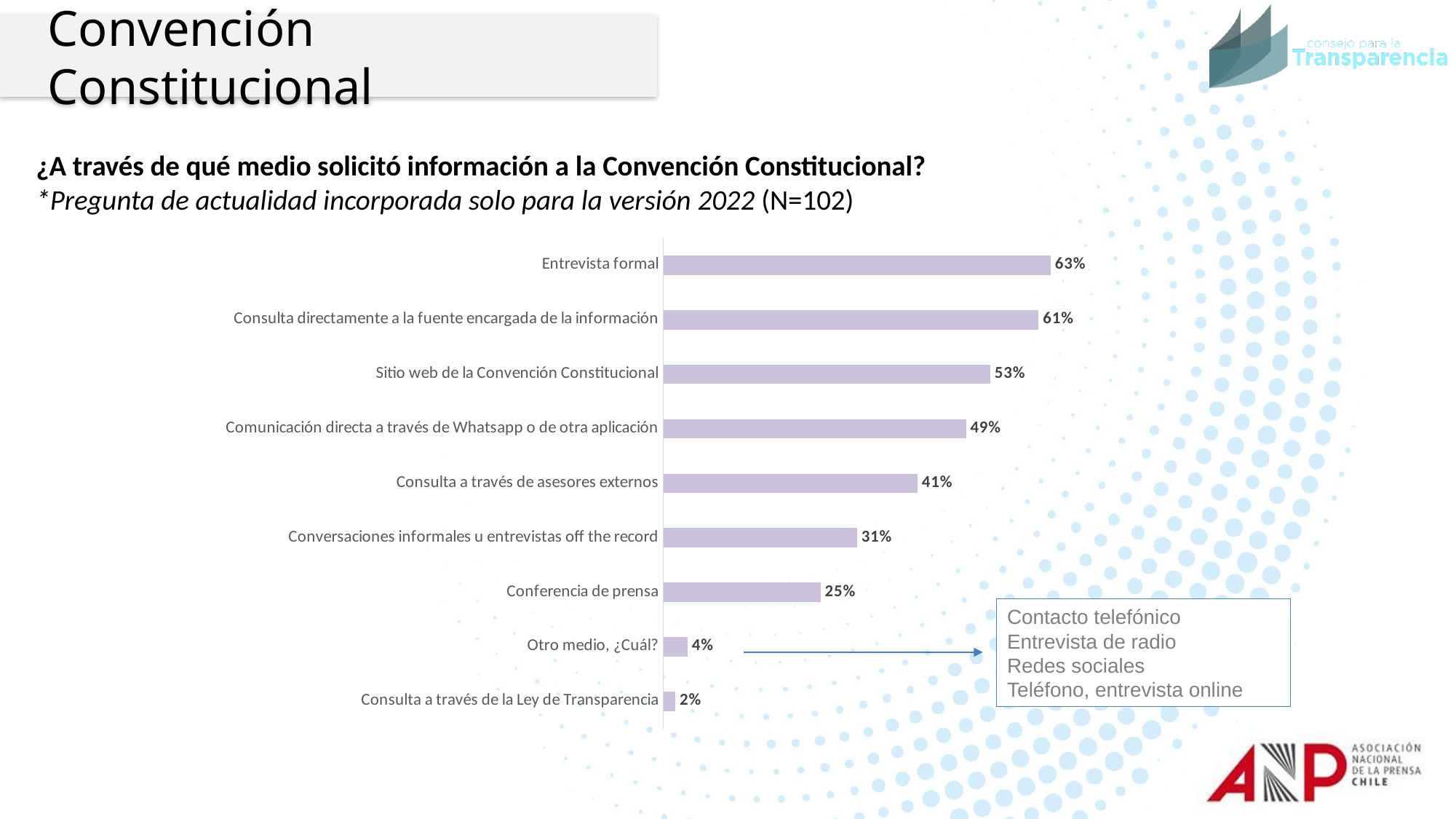
What is the value shown for 'Sitio web de la Convención Constitucional'? 53% What percentage is shown for 'Conferencia de prensa'? 25% What percentage of respondents requested information through 'Entrevista formal'? 63% Which category has the highest value in the chart? Entrevista formal What kind of chart is shown on the slide? Bar chart What sample size (N) is stated for this question on the slide? N=102 What is the value for 'Otro medio, ¿Cuál?'? 4% What is the difference between 'Entrevista formal' and 'Consulta a través de asesores externos'? 22% Which is larger: 'Comunicación directa a través de Whatsapp o de otra aplicación' or 'Conversaciones informales u entrevistas off the record'? Comunicación directa a través de Whatsapp o de otra aplicación How many categories are shown in the chart? 9 Which category has the lowest value in the chart? Consulta a través de la Ley de Transparencia What is the value for 'Consulta a través de la Ley de Transparencia'? 2%